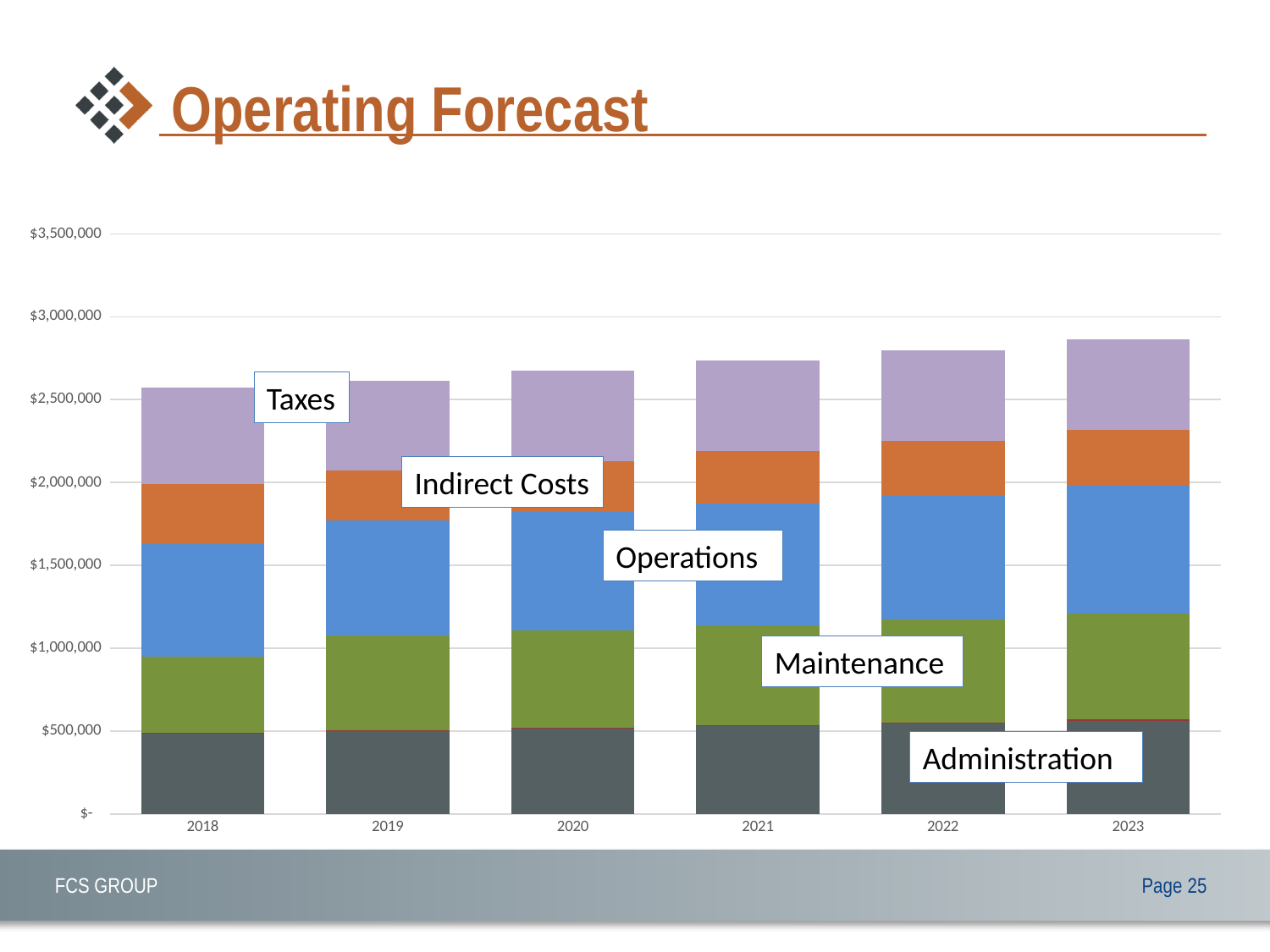
Do the total operating costs rise or fall from 2018 to 2023? rise Which year has the highest total operating cost bar? 2023 How many years are shown on the x axis of the chart? 6 Is the total bar for 2023 greater or less than $2,500,000? greater Is the total bar for 2018 greater or less than $3,000,000? less Which is larger, the total bar for 2023 or the total bar for 2018? 2023 Is the total bar for 2023 greater or less than $3,000,000? less What kind of chart is shown on the slide? stacked bar chart What is the title of the slide containing the chart? Operating Forecast Which year has the lowest total operating cost bar? 2018 How many cost categories are labeled on the chart? 5 Which cost category is shown at the bottom of each stacked bar? Administration